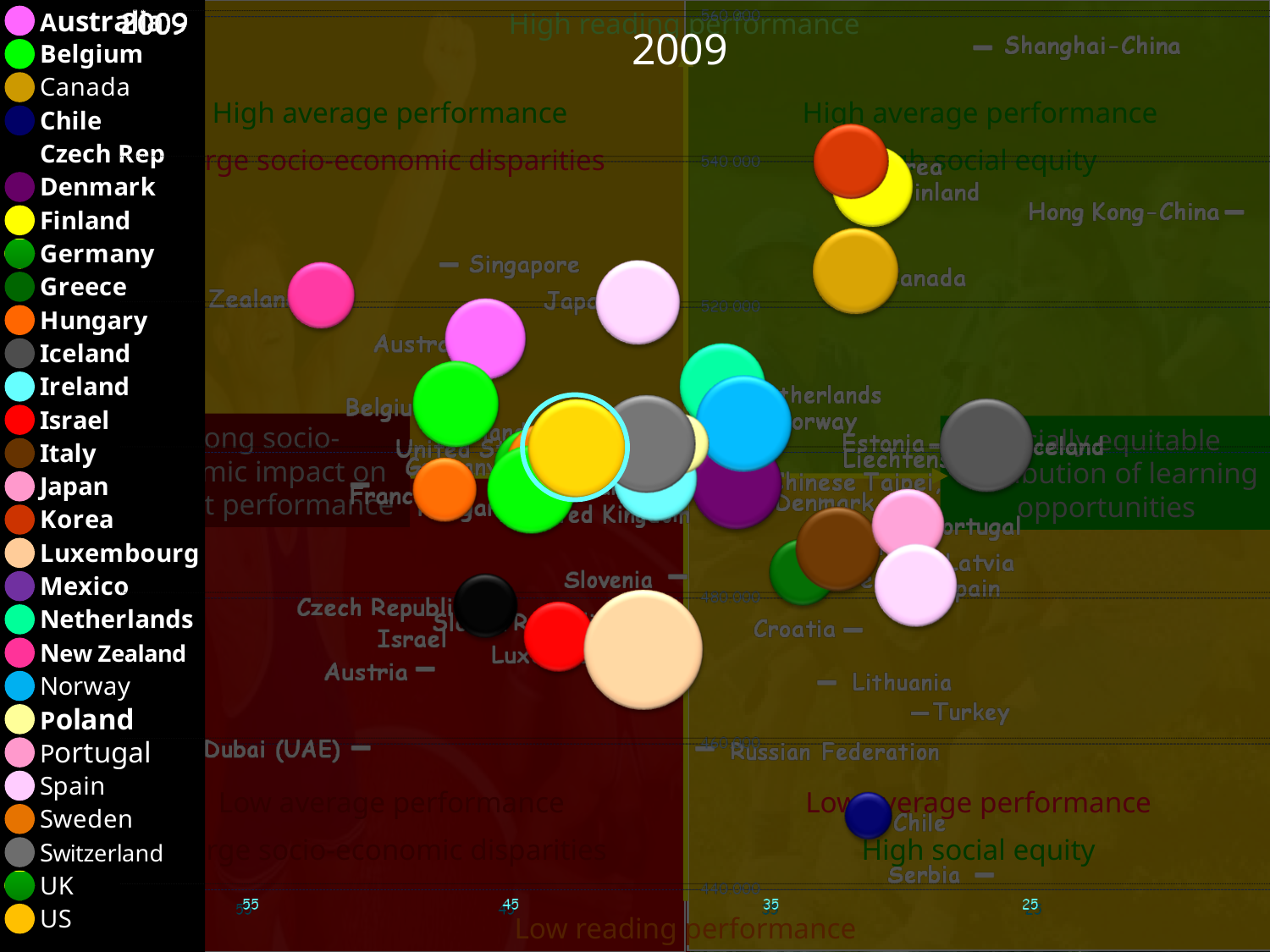
What is the title of the chart? 2009 Is the x-axis value for Luxembourg greater or less than 45? less Is the x-axis value for New Zealand greater or less than 45? greater Is the x-axis value for Belgium greater or less than 45? greater What label describes the lower-right quadrant of the chart? Low average performance, High social equity How many countries does the legend list? 28 What kind of chart is shown on the slide? bubble chart